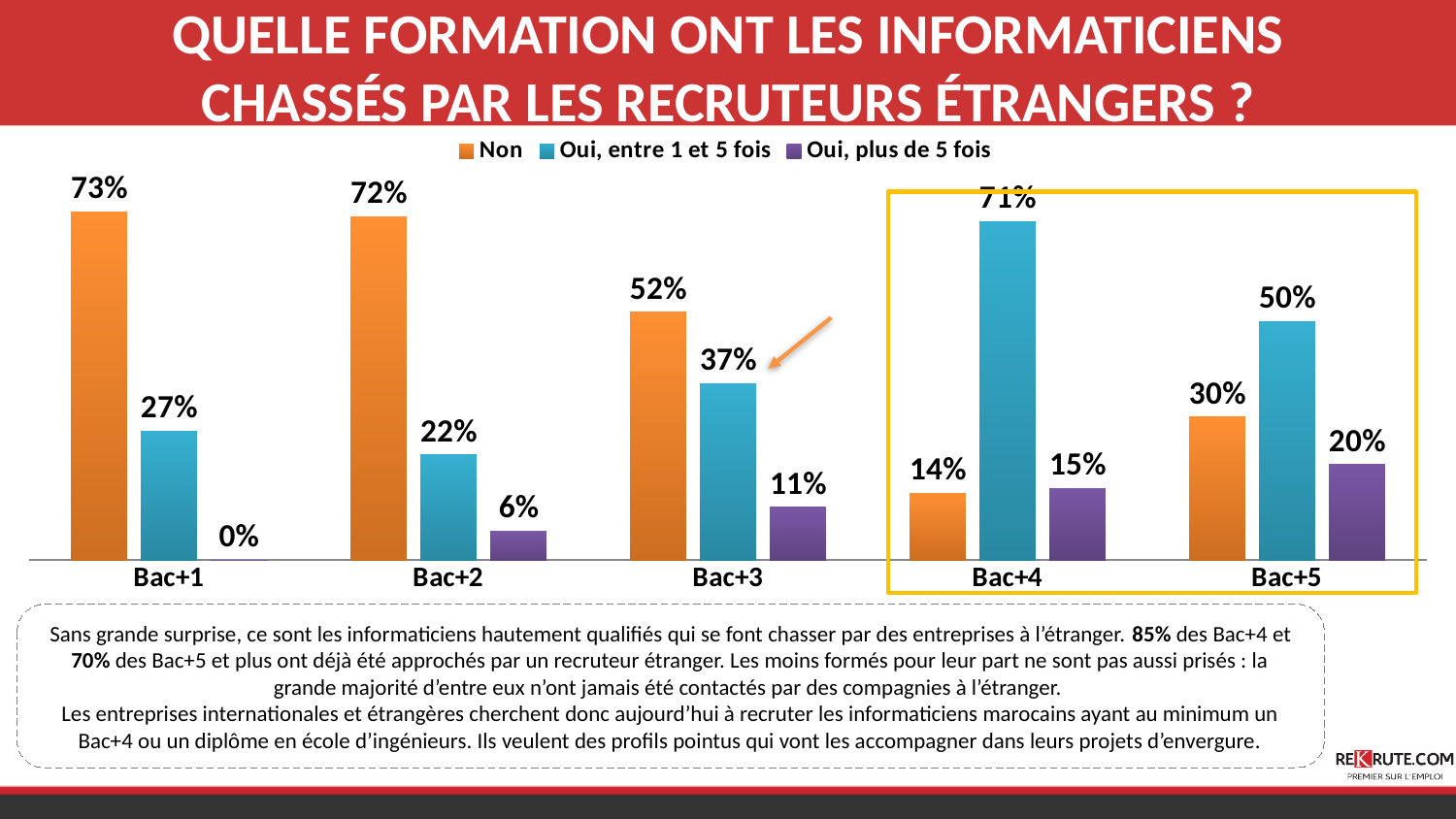
Which category has the highest value for the 'Non' series? Bac+1 How many categories are shown on the x axis? 5 How many series does the legend list? 3 Which category has the lowest value for the 'Non' series? Bac+4 What kind of chart is shown on the slide? Bar chart What is the value of 'Oui, entre 1 et 5 fois' for Bac+4? 71% For Bac+5, which is larger: 'Non' or 'Oui, entre 1 et 5 fois'? Oui, entre 1 et 5 fois Does the 'Oui, plus de 5 fois' series rise or fall from Bac+1 to Bac+5? Rise What is the value of the 'Non' series for Bac+1? 73% What is the value of 'Oui, plus de 5 fois' for Bac+1? 0% What is the difference between the 'Non' value for Bac+3 and the 'Non' value for Bac+4? 38% What is the value of 'Oui, plus de 5 fois' for Bac+5? 20%